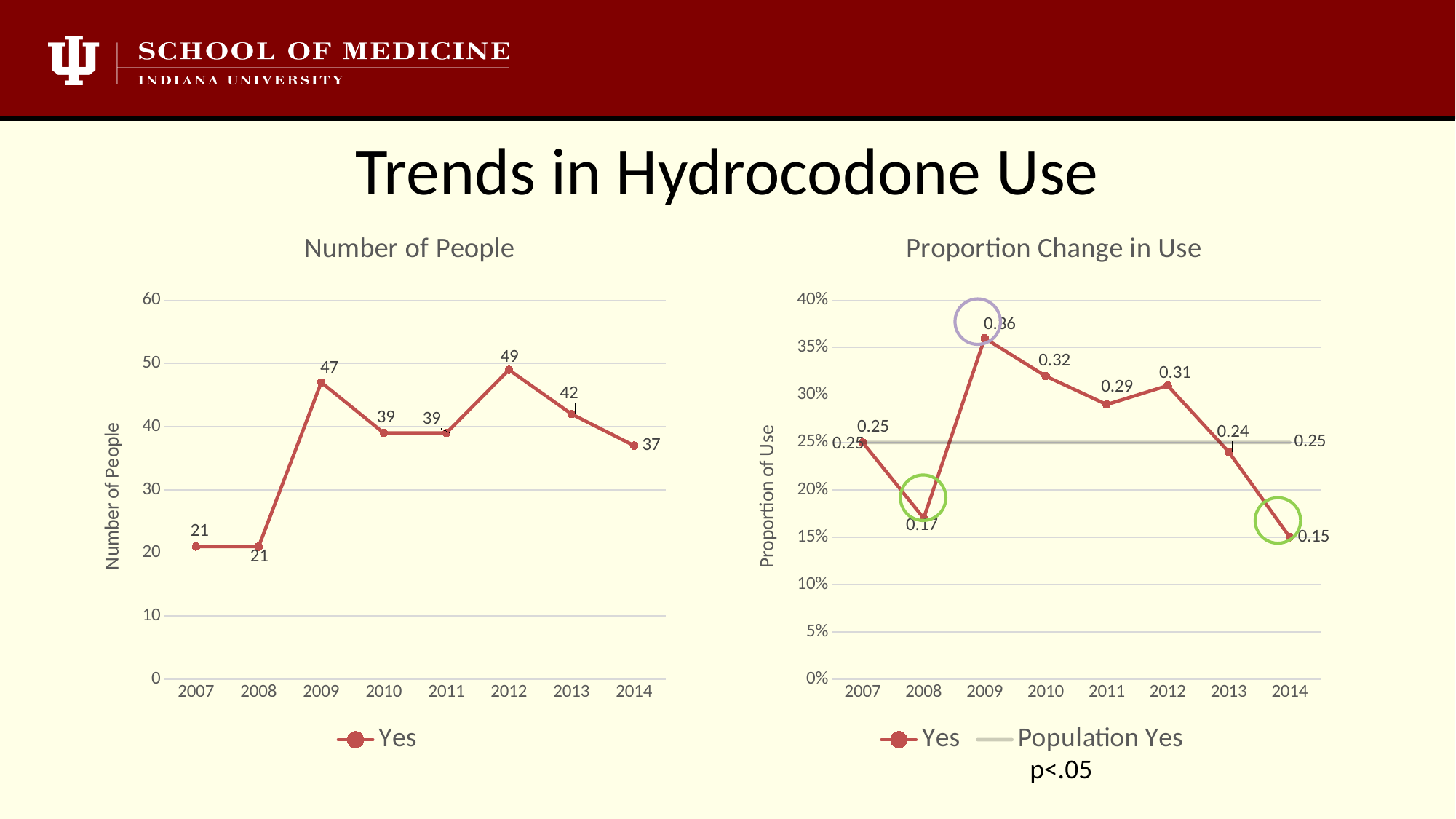
In the 'Proportion Change in Use' chart, what is the value of the 'Yes' series for 2009? 0.36 In the 'Number of People' chart, which year has the highest value? 2012 In the 'Proportion Change in Use' chart, what is the value of the 'Population Yes' series? 0.25 In the 'Number of People' chart, what is the difference between the values for 2012 and 2014? 12 In the 'Proportion Change in Use' chart, how many series does the legend list? 2 What kind of chart is the 'Number of People' chart? Line chart In the 'Number of People' chart, how many years are plotted on the x axis? 8 In the 'Number of People' chart, what is the value for 2009? 47 In the 'Proportion Change in Use' chart, which year has the lowest 'Yes' value? 2014 In the 'Proportion Change in Use' chart, do the 'Yes' values rise or fall from 2012 to 2014? Fall In the 'Proportion Change in Use' chart, which is larger, the 'Yes' value for 2010 or for 2011? 2010 In the 'Number of People' chart, is the value for 2013 greater or less than 40? greater